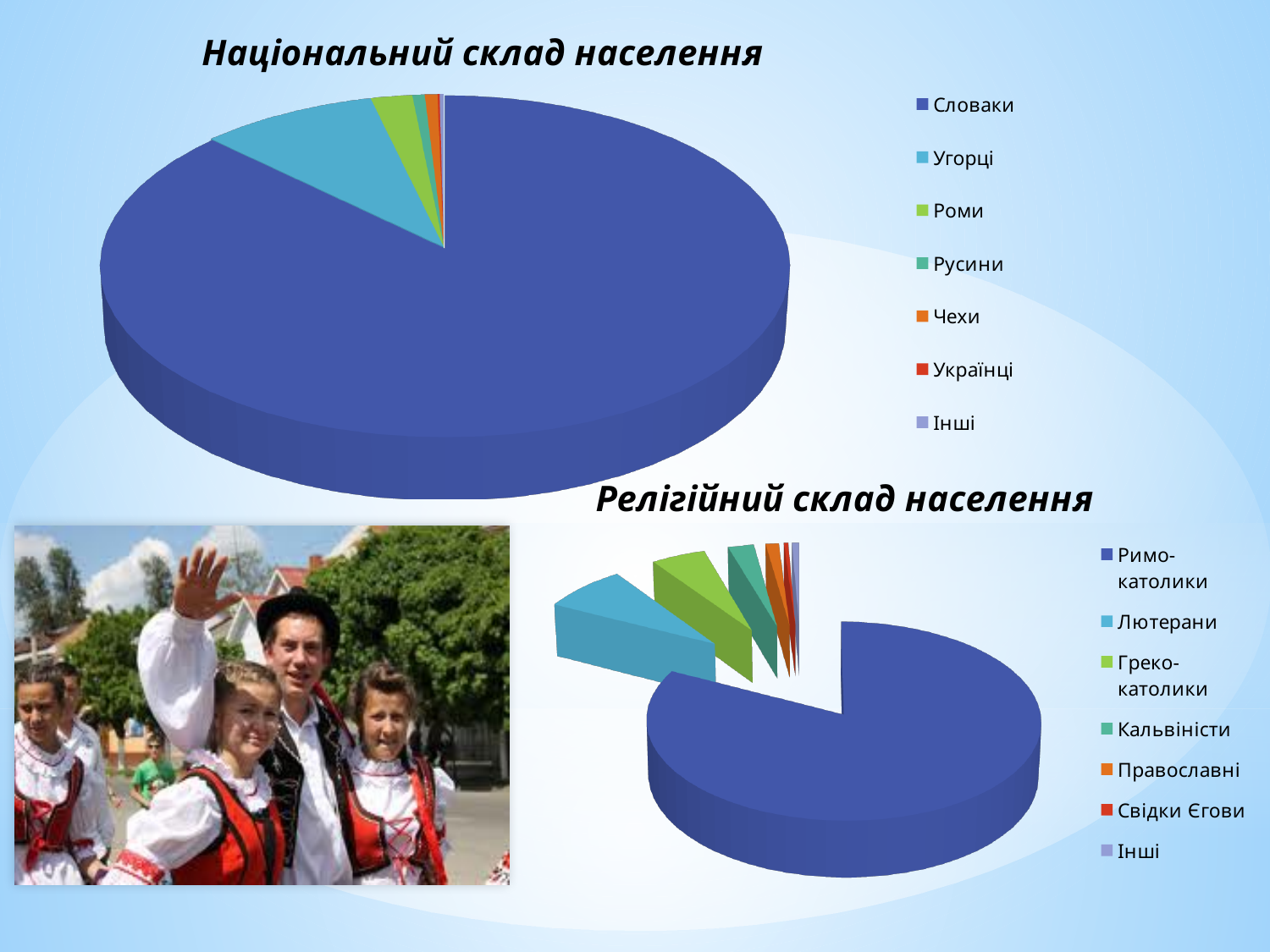
In the "Релігійний склад населення" chart, how many categories does the legend list? 7 In the "Релігійний склад населення" chart, which legend entry is shown in light blue? Лютерани In the "Релігійний склад населення" chart, which slice is larger: Лютерани or Греко-католики? Лютерани In the "Релігійний склад населення" chart, which slice is larger: Греко-католики or Кальвіністи? Греко-католики In the "Національний склад населення" chart, how many categories does the legend list? 7 In the "Національний склад населення" chart, which slice is larger: Роми or Русини? Роми In the "Національний склад населення" chart, which category has the largest slice? Словаки What kind of chart is the "Національний склад населення" chart? pie chart What kind of chart is the "Релігійний склад населення" chart? pie chart What is the title of the upper chart on the slide? Національний склад населення In the "Релігійний склад населення" chart, which category has the largest slice? Римо-католики